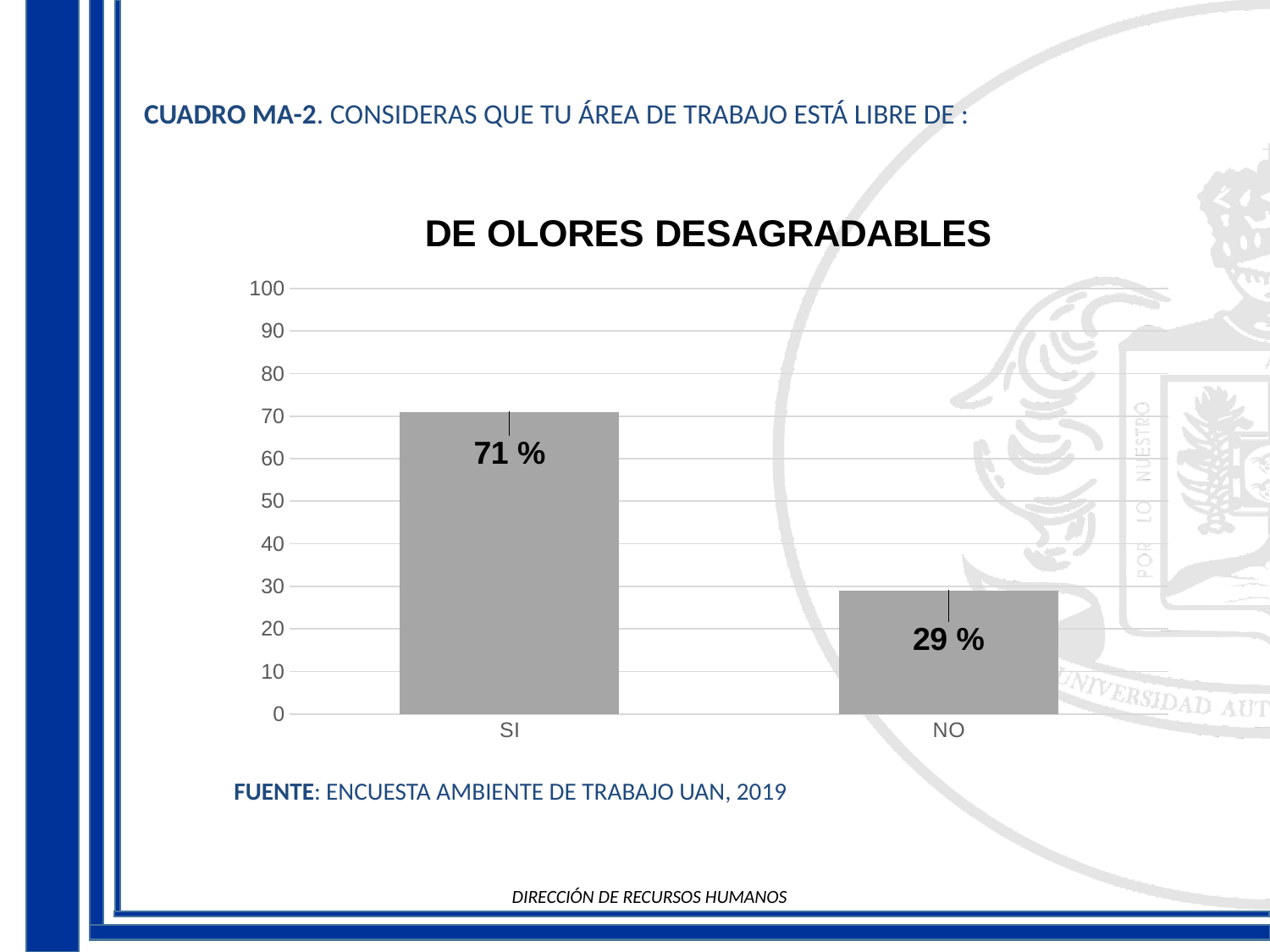
What is the value for SI? 71 % What is the highest value shown on the y axis? 100 What is the title of the chart? DE OLORES DESAGRADABLES What is the difference between the values for SI and NO? 42 % Is the value for NO greater or less than 40? less Which category has the lowest value? NO How many categories are shown on the x axis? 2 Which category has the highest value? SI Which is larger, the value for SI or the value for NO? SI What kind of chart is shown? bar chart Is the value for SI greater or less than 60? greater What is the value for NO? 29 %